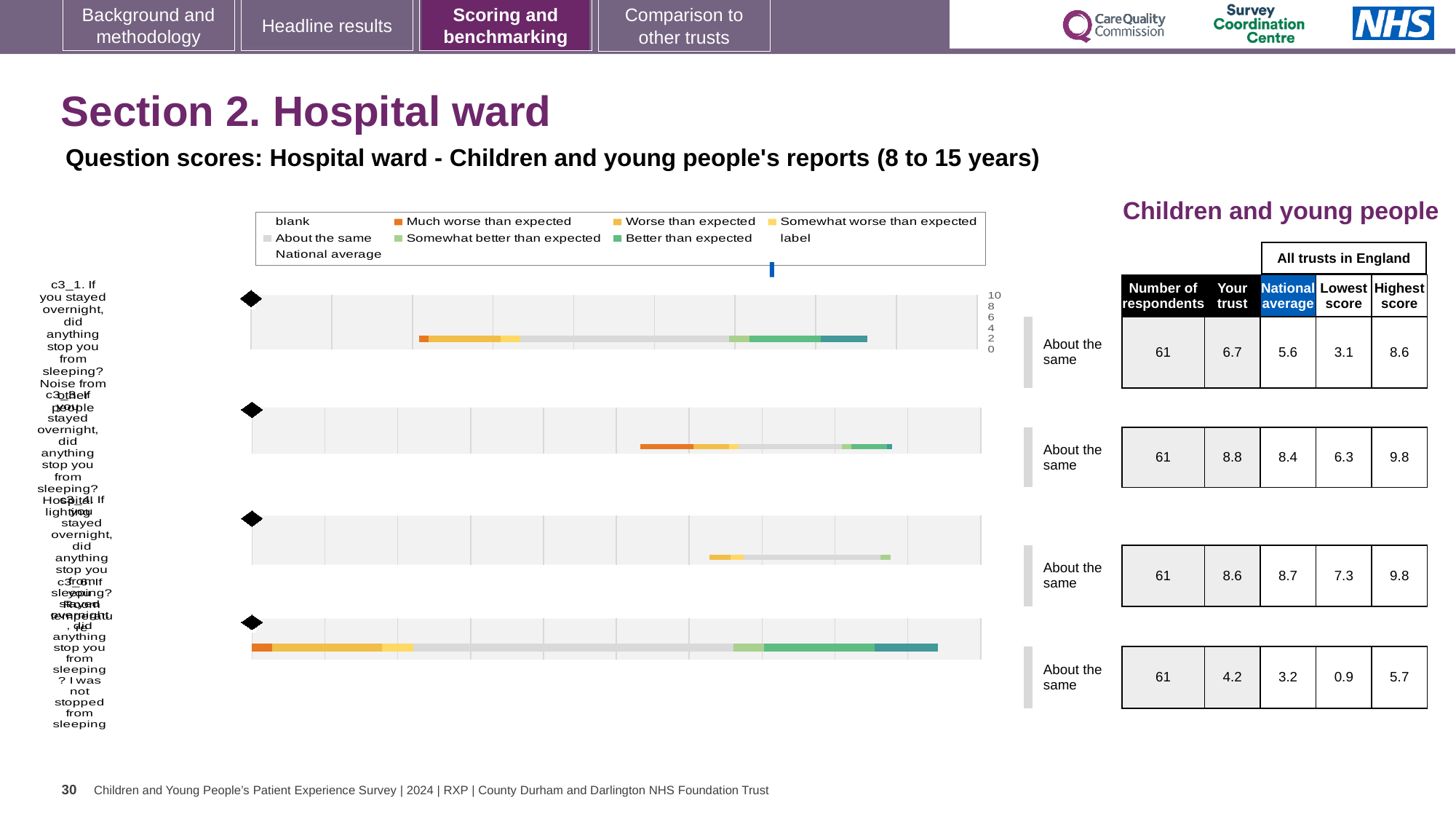
How many entries does the chart legend list? 9 In the chart legend, which category is shown in orange? Much worse than expected In the table beside the charts, what is the 'Your trust' score for the first question (c3_1, noise from other people)? 6.7 In the table beside the charts, what is the difference between the 'Your trust' score and the national average for the fourth question (c3_6)? 1.0 What kind of chart is used for the question scores on this slide? bar chart What is the highest value shown on the chart's score axis? 10 In the table beside the charts, which question has the lowest 'Your trust' score? c3_6 (I was not stopped from sleeping) In the table beside the charts, what is the national average for the second question (c3_3, hospital lighting)? 8.4 In the table beside the charts, is the 'Your trust' score for the third question (c3_4) higher or lower than its national average? lower In the chart legend, which category is shown in grey? About the same How many separate bar charts (one per question) are shown on the slide? 4 In the table beside the charts, how many respondents are listed for each question? 61